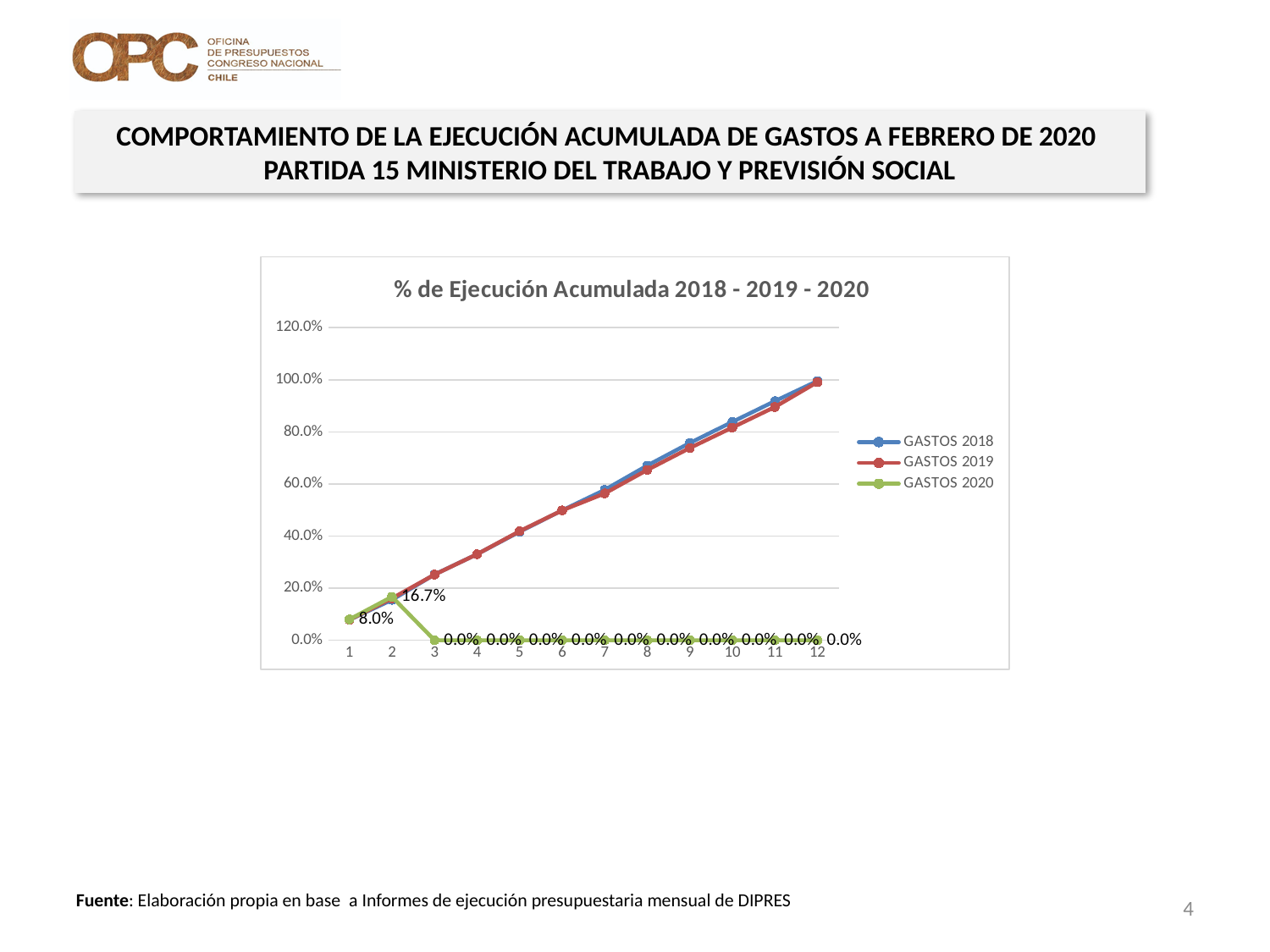
How many series does the legend list? 3 Do the GASTOS 2019 values rise or fall from point 1 to point 12? rise At which point on the x axis does GASTOS 2020 reach its highest value? 2 Is the value for GASTOS 2019 at point 12 greater or less than 80.0%? greater What is the difference between the GASTOS 2020 values at point 2 and point 1? 8.7% What kind of chart is shown on the slide? line chart Is the value for GASTOS 2019 at point 3 greater or less than 40.0%? less How many points are plotted along the x axis for each series? 12 What is the value of GASTOS 2020 at point 5? 0.0% What is the title of the chart? % de Ejecución Acumulada 2018 - 2019 - 2020 What is the value of GASTOS 2020 at point 1? 8.0% What is the value of GASTOS 2020 at point 2? 16.7%